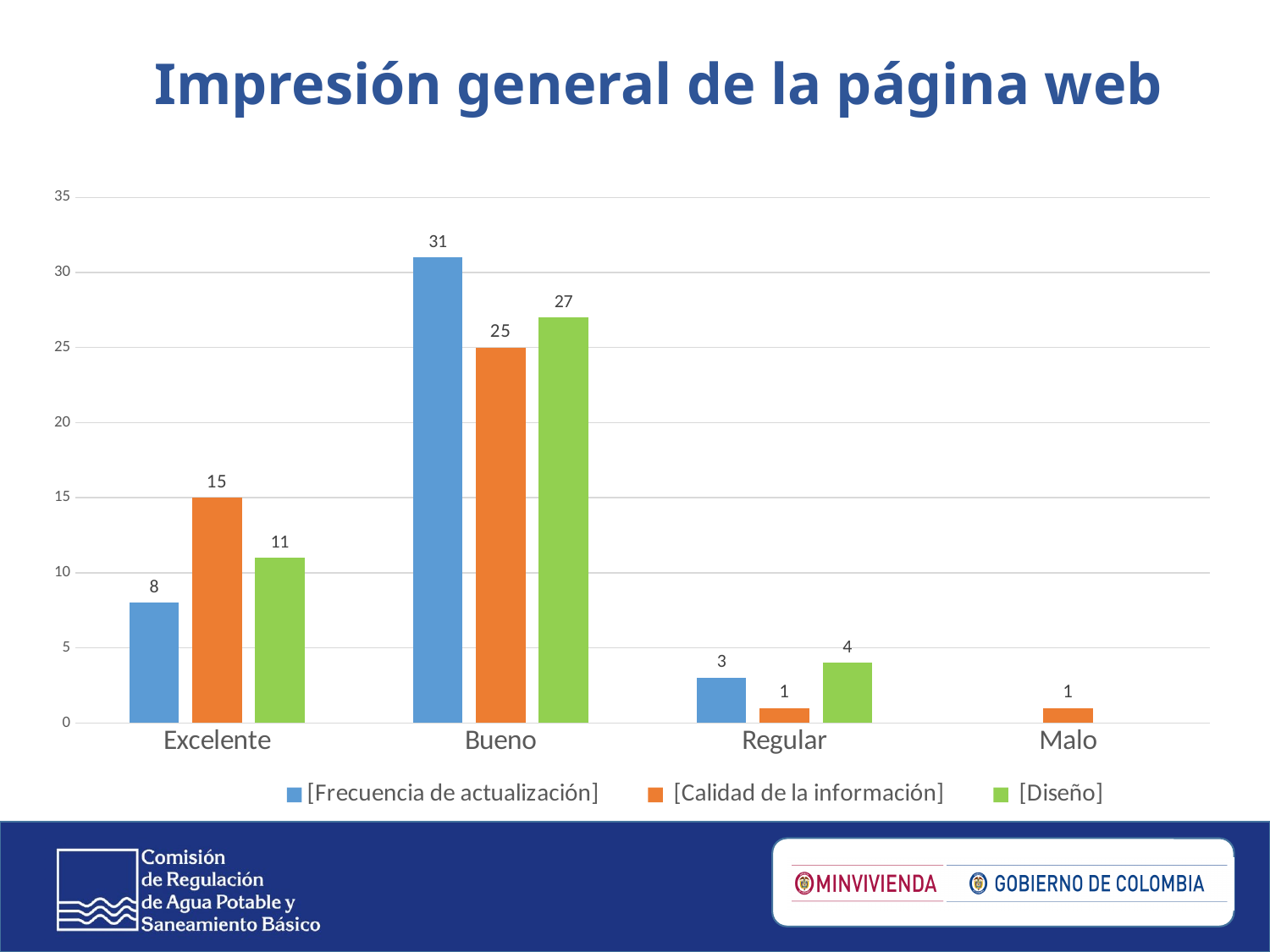
How many series does the legend list? 3 Which colour represents the Diseño series? Green What is the difference between Frecuencia de actualización and Calidad de la información in the Bueno category? 6 Which category has the highest value for Calidad de la información? Bueno What is the value for Frecuencia de actualización in the Bueno category? 31 What is the value for Calidad de la información in the Malo category? 1 What is the title of the slide? Impresión general de la página web How many categories are shown on the x axis? 4 Which category has the lowest value for Diseño among those with a plotted bar? Regular What is the value for Diseño in the Excelente category? 11 What kind of chart is shown on the slide? Bar chart In the Excelente category, which is larger: Calidad de la información or Frecuencia de actualización? Calidad de la información